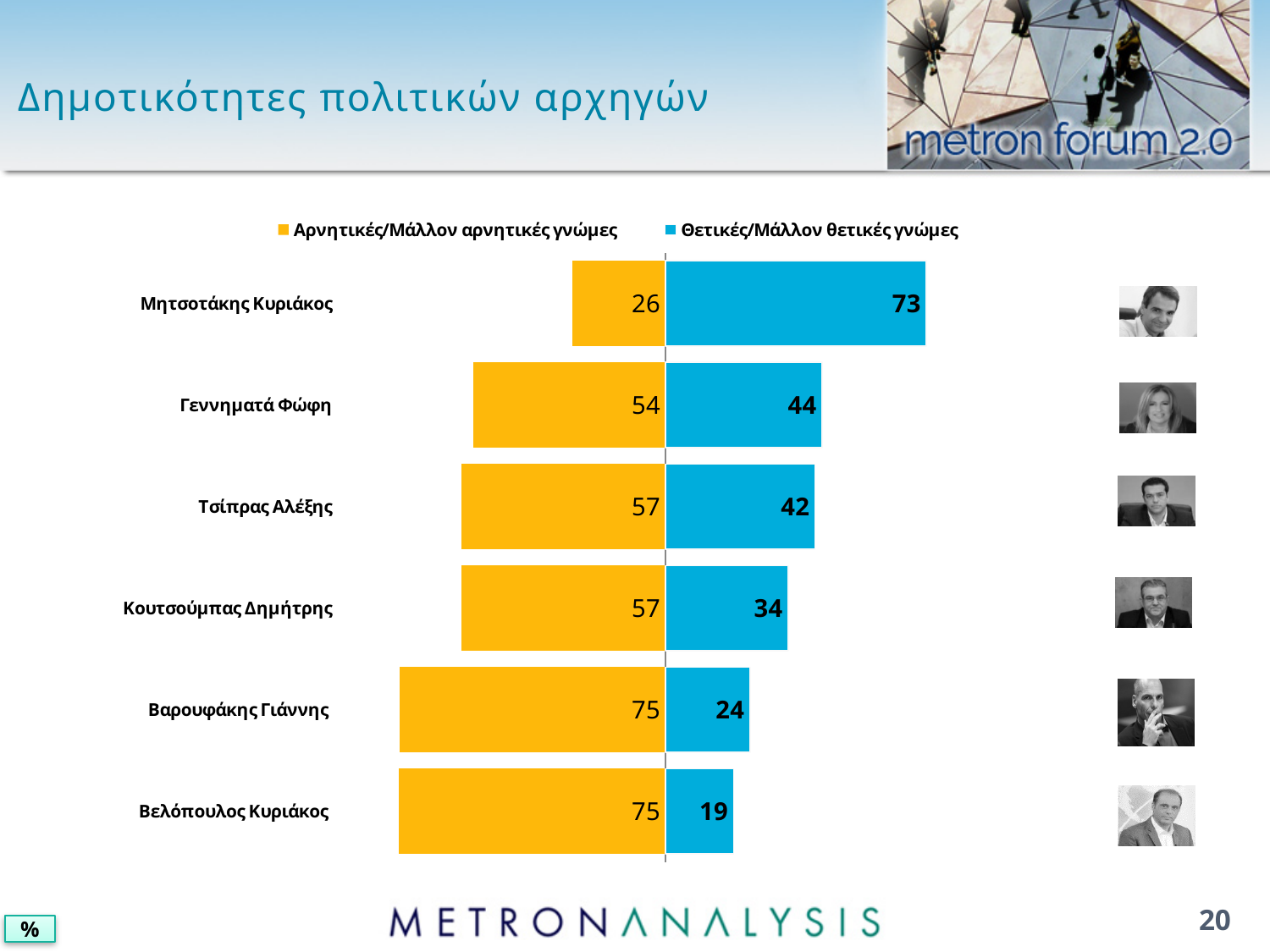
How many politicians are shown in the chart? 6 What is the difference between the Θετικές/Μάλλον θετικές γνώμες values for Μητσοτάκης Κυριάκος and Τσίπρας Αλέξης? 31 Which politician has the lowest value for Αρνητικές/Μάλλον αρνητικές γνώμες? Μητσοτάκης Κυριάκος Which colour represents Θετικές/Μάλλον θετικές γνώμες in the chart? Blue What is the total of Αρνητικές/Μάλλον αρνητικές γνώμες and Θετικές/Μάλλον θετικές γνώμες for Βαρουφάκης Γιάννης? 99 What kind of chart is shown on the slide? Bar chart How many series does the legend list? 2 Which politician has the highest value for Θετικές/Μάλλον θετικές γνώμες? Μητσοτάκης Κυριάκος What is the value of Θετικές/Μάλλον θετικές γνώμες for Βελόπουλος Κυριάκος? 19 Which is larger for Κουτσούμπας Δημήτρης: Αρνητικές/Μάλλον αρνητικές γνώμες or Θετικές/Μάλλον θετικές γνώμες? Αρνητικές/Μάλλον αρνητικές γνώμες What is the value of Αρνητικές/Μάλλον αρνητικές γνώμες for Γεννηματά Φώφη? 54 What is the value of Θετικές/Μάλλον θετικές γνώμες for Μητσοτάκης Κυριάκος? 73